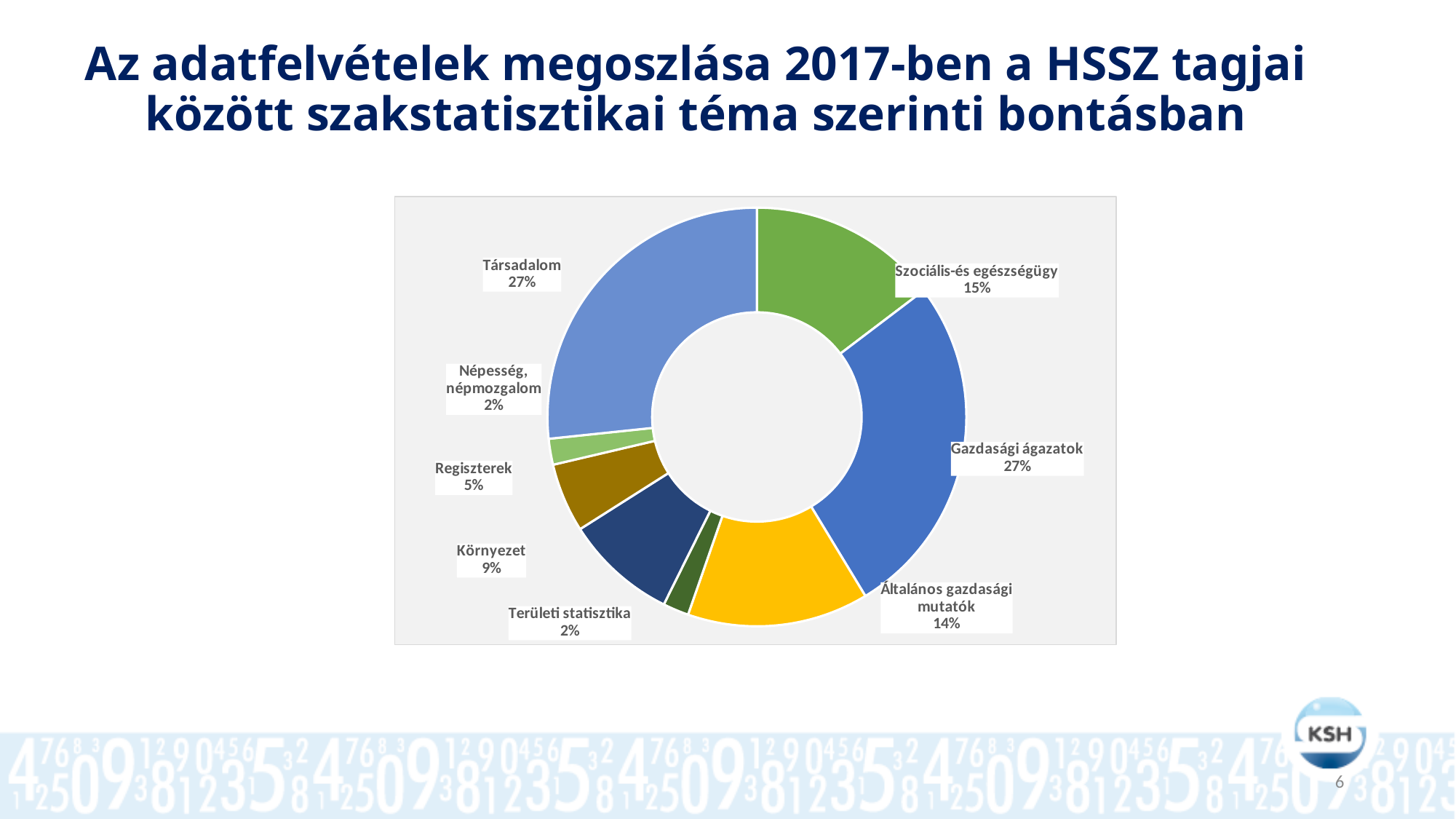
What share does Társadalom have? 27% How many categories are shown in the chart? 8 Which is larger, the share for Környezet or the share for Regiszterek? Környezet What kind of chart is shown on the slide? Doughnut (pie) chart What is the difference in percentage points between Gazdasági ágazatok and Általános gazdasági mutatók? 13 What percentage is labelled for Regiszterek? 5% What is the difference in percentage points between Környezet and Területi statisztika? 7 What is the value labelled for Környezet? 9% Which is larger, Szociális-és egészségügy or Általános gazdasági mutatók? Szociális-és egészségügy What percentage is shown for Szociális-és egészségügy? 15% What share does Gazdasági ágazatok have in the chart? 27% What share is shown for Általános gazdasági mutatók? 14%